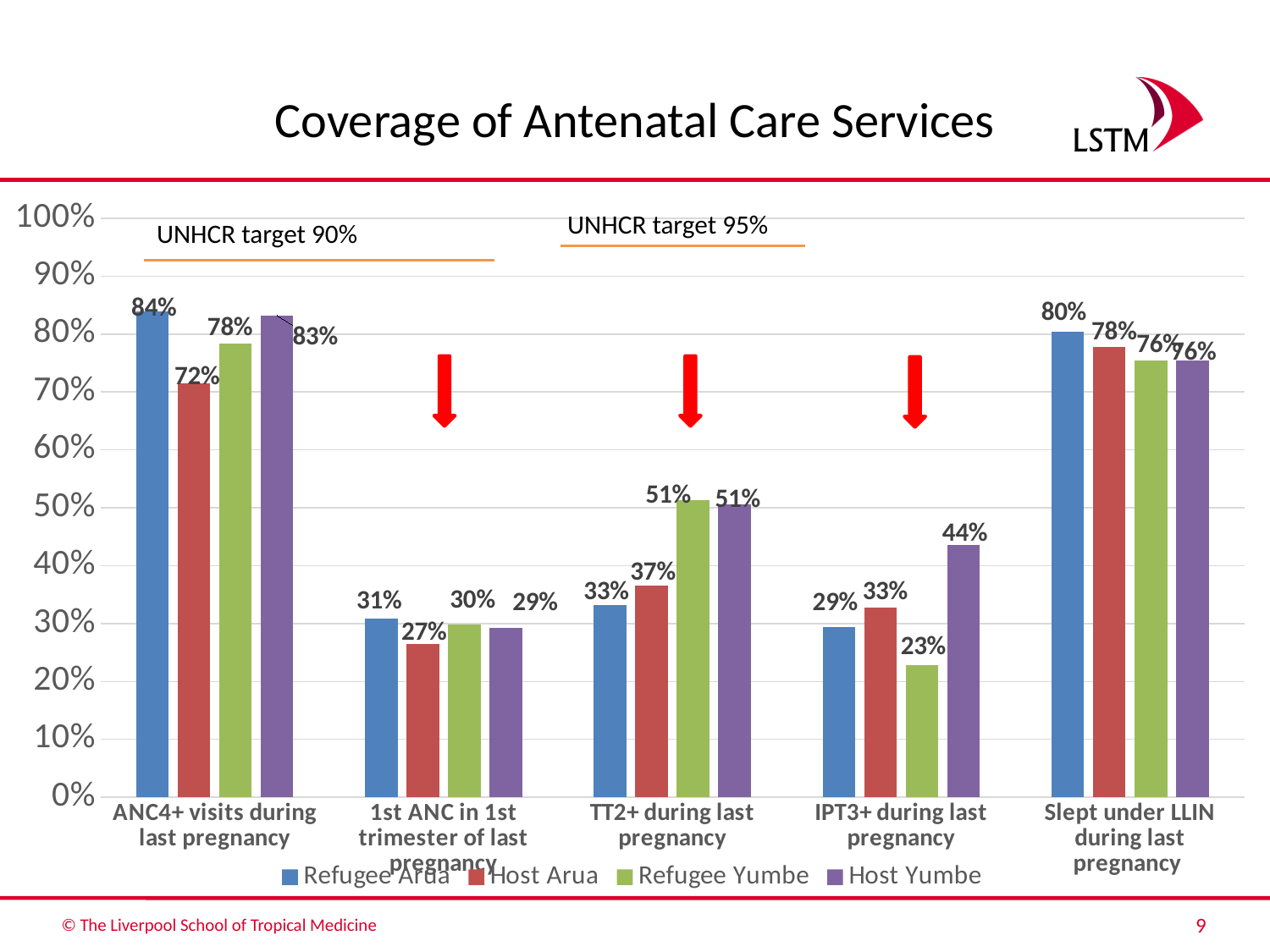
What kind of chart is shown on the slide? bar chart Which series has the lowest value for IPT3+ during last pregnancy? Refugee Yumbe What is the value for Host Yumbe for IPT3+ during last pregnancy? 44% What UNHCR target is shown above the ANC4+ visits category? UNHCR target 90% What is the value for Host Arua for 1st ANC in 1st trimester of last pregnancy? 27% Which is larger for TT2+ during last pregnancy: Refugee Arua or Refugee Yumbe? Refugee Yumbe How many series does the legend list? 4 How many categories are shown on the x axis? 5 What is the value for Refugee Arua for ANC4+ visits during last pregnancy? 84% Which series has the highest value for Slept under LLIN during last pregnancy? Refugee Arua Is the value for Host Arua for ANC4+ visits during last pregnancy greater or less than 80%? less What is the difference between Host Yumbe and Refugee Yumbe for IPT3+ during last pregnancy? 21%